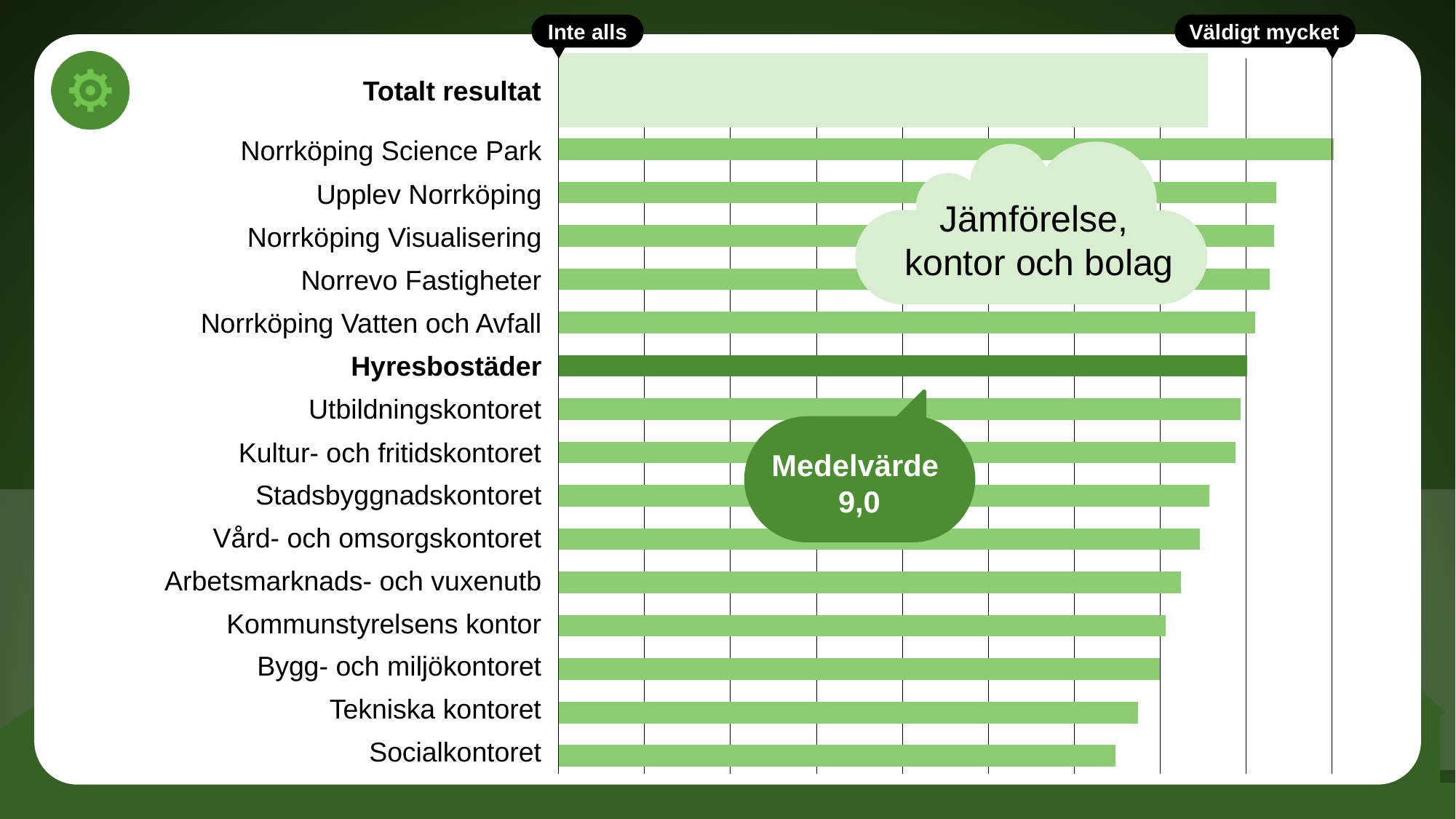
What title is shown in the cloud shape on the chart? Jämförelse, kontor och bolag Which has the larger value, Hyresbostäder or Socialkontoret? Hyresbostäder Which has the larger value, Upplev Norrköping or Kommunstyrelsens kontor? Upplev Norrköping What are the labels at the left and right ends of the chart's axis? Inte alls and Väldigt mycket What kind of chart is shown on the slide? bar chart Which has the larger value, Norrköping Vatten och Avfall or Bygg- och miljökontoret? Norrköping Vatten och Avfall How many organisation bars are plotted below the Totalt resultat bar? 15 Do the bar values rise or fall going from the top organisation to the bottom one? fall Which organisation has the shortest bar in the chart? Socialkontoret What mean value (Medelvärde) is shown in the callout on the chart? 9,0 Which organisation has the longest bar in the chart? Norrköping Science Park